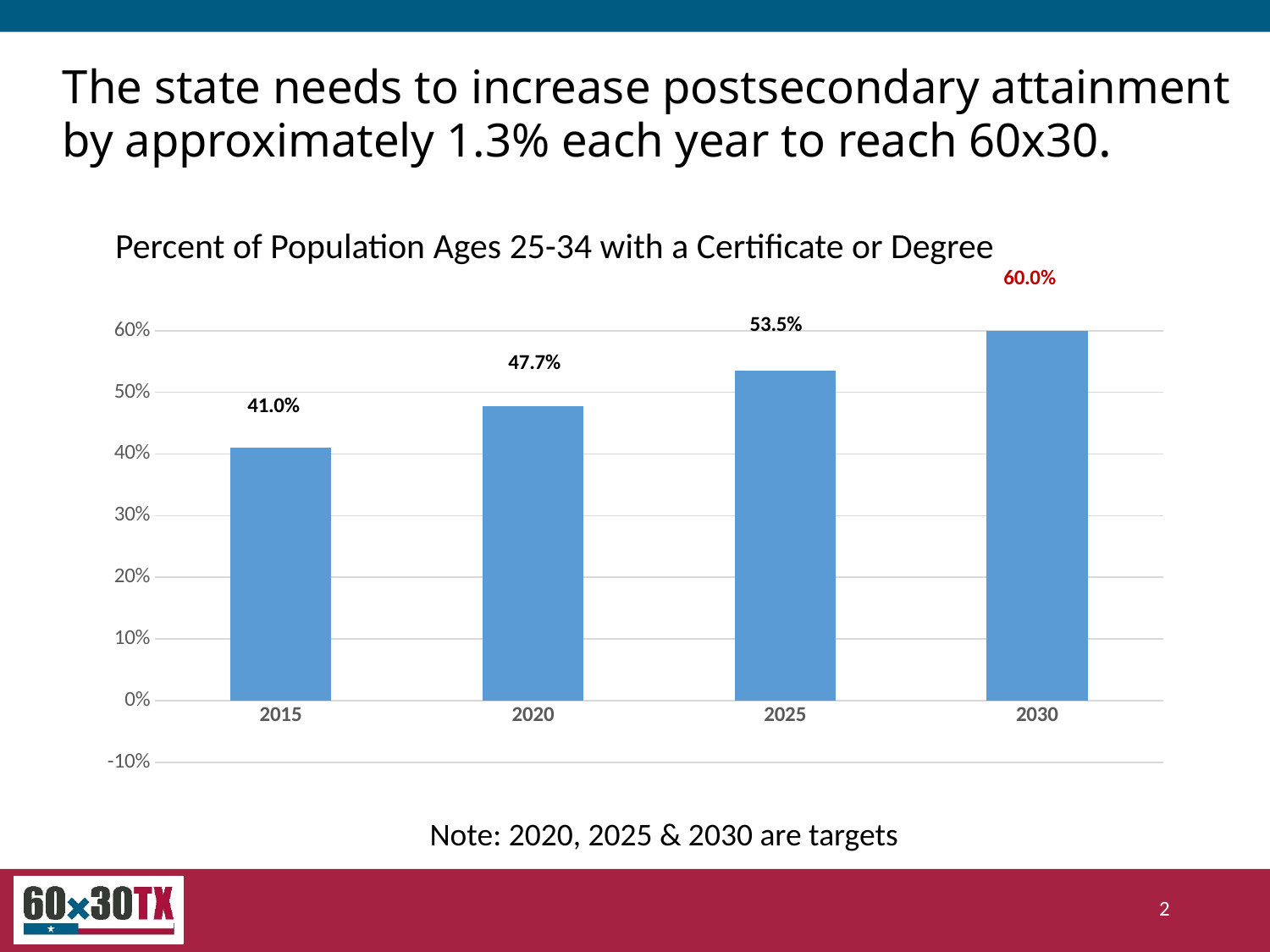
What is the difference between the values for 2030 and 2015? 19.0% What is the value for 2020? 47.7% What is the value for 2015? 41.0% How many years are shown on the x axis? 4 What is the value for 2025? 53.5% What is the difference between the values for 2025 and 2020? 5.8% Which year has the lowest value? 2015 Which year has the highest value? 2030 Which is larger, the value for 2020 or the value for 2025? 2025 Do the values rise or fall from 2015 to 2030? rise What kind of chart is this? bar chart What is the value for 2030? 60.0%